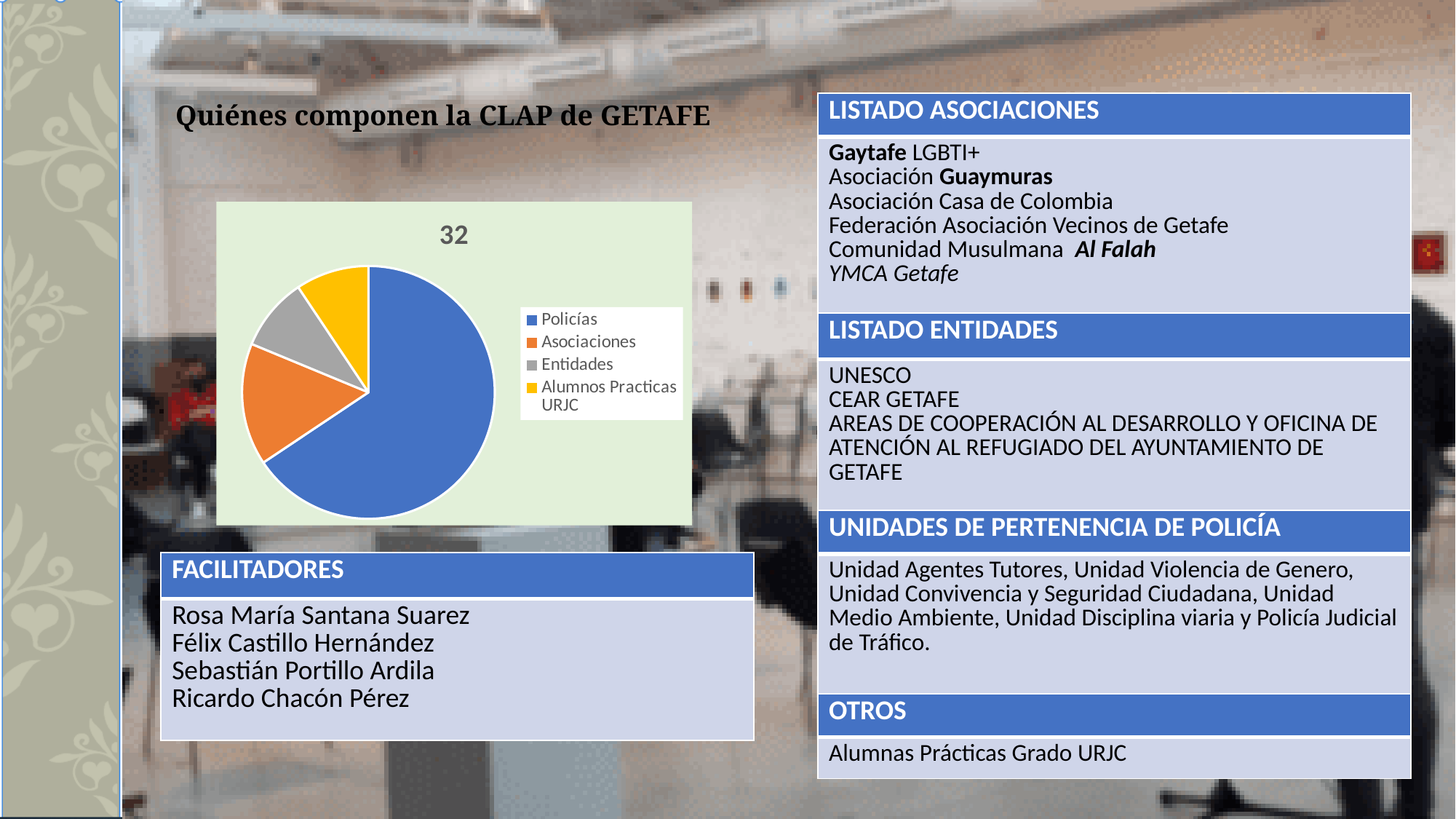
Which slice is larger in the pie chart, Policías or Asociaciones? Policías Which category is shown in yellow in the pie chart? Alumnos Practicas URJC What kind of chart is shown on the slide? pie chart Which category is the second largest slice in the pie chart? Asociaciones Which category has the largest slice in the pie chart? Policías How many entries does the legend of the pie chart list? 4 How many categories does the pie chart have? 4 Which slice is larger in the pie chart, Asociaciones or Entidades? Asociaciones What is the title shown above the pie chart? 32 Which slice is larger in the pie chart, Policías or Alumnos Practicas URJC? Policías